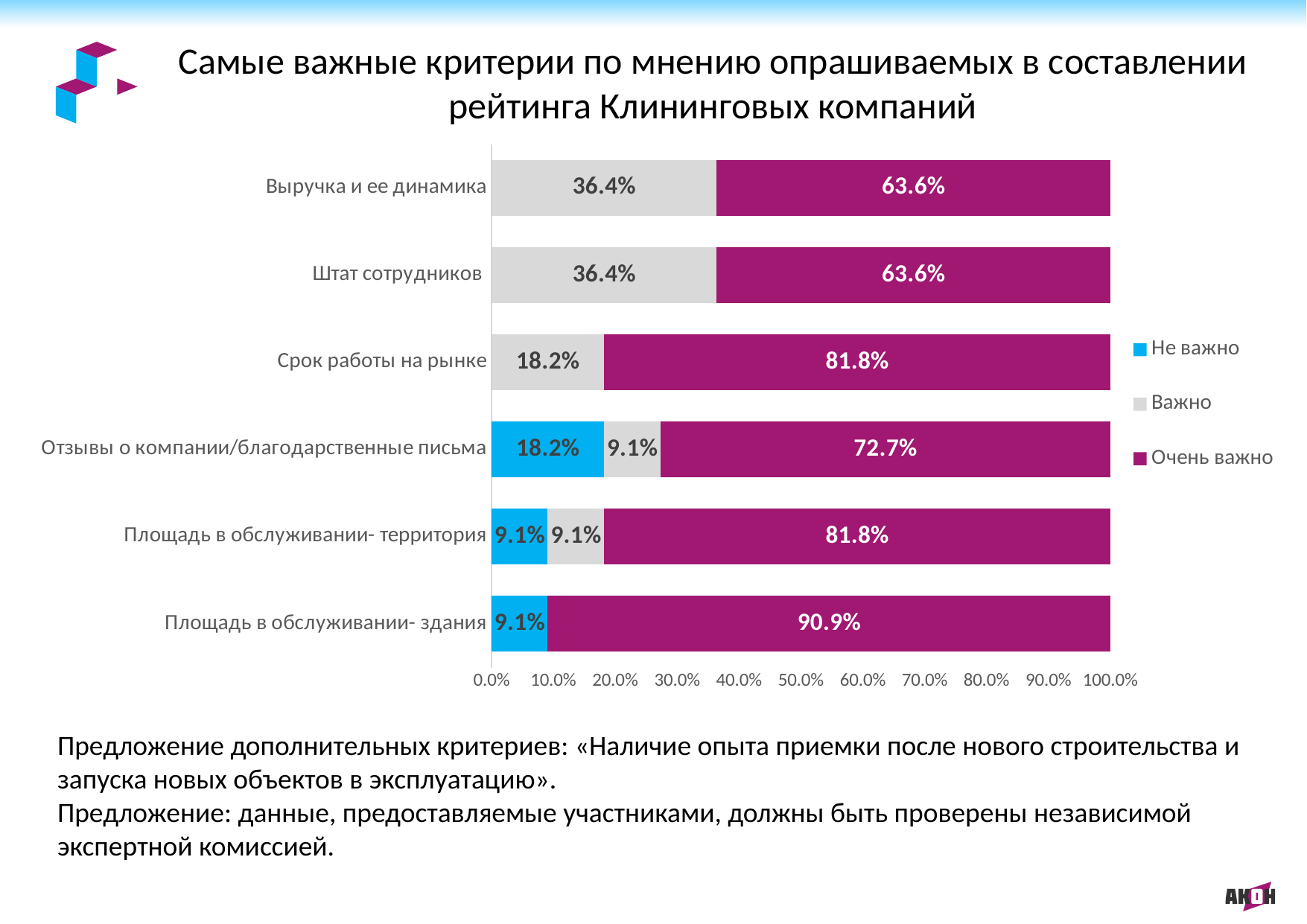
What is the "Важно" value for "Выручка и ее динамика"? 36.4% Which is larger: the "Очень важно" share for "Отзывы о компании/благодарственные письма" or for "Срок работы на рынке"? Срок работы на рынке Which colour represents the "Не важно" series in the legend? Blue What is the difference between the "Очень важно" shares for "Площадь в обслуживании- здания" and "Штат сотрудников"? 27.3% What type of chart is shown on the slide? Stacked bar chart Which criteria have the lowest "Очень важно" share? Выручка и ее динамика and Штат сотрудников Which criterion has the highest "Очень важно" share? Площадь в обслуживании- здания How many series does the legend list? 3 What is the total of the stacked bar for "Площадь в обслуживании- территория"? 100.0% How many criteria (categories) are shown in the chart? 6 What is the "Не важно" value for "Отзывы о компании/благодарственные письма"? 18.2% What share of respondents rated "Срок работы на рынке" as "Очень важно"? 81.8%